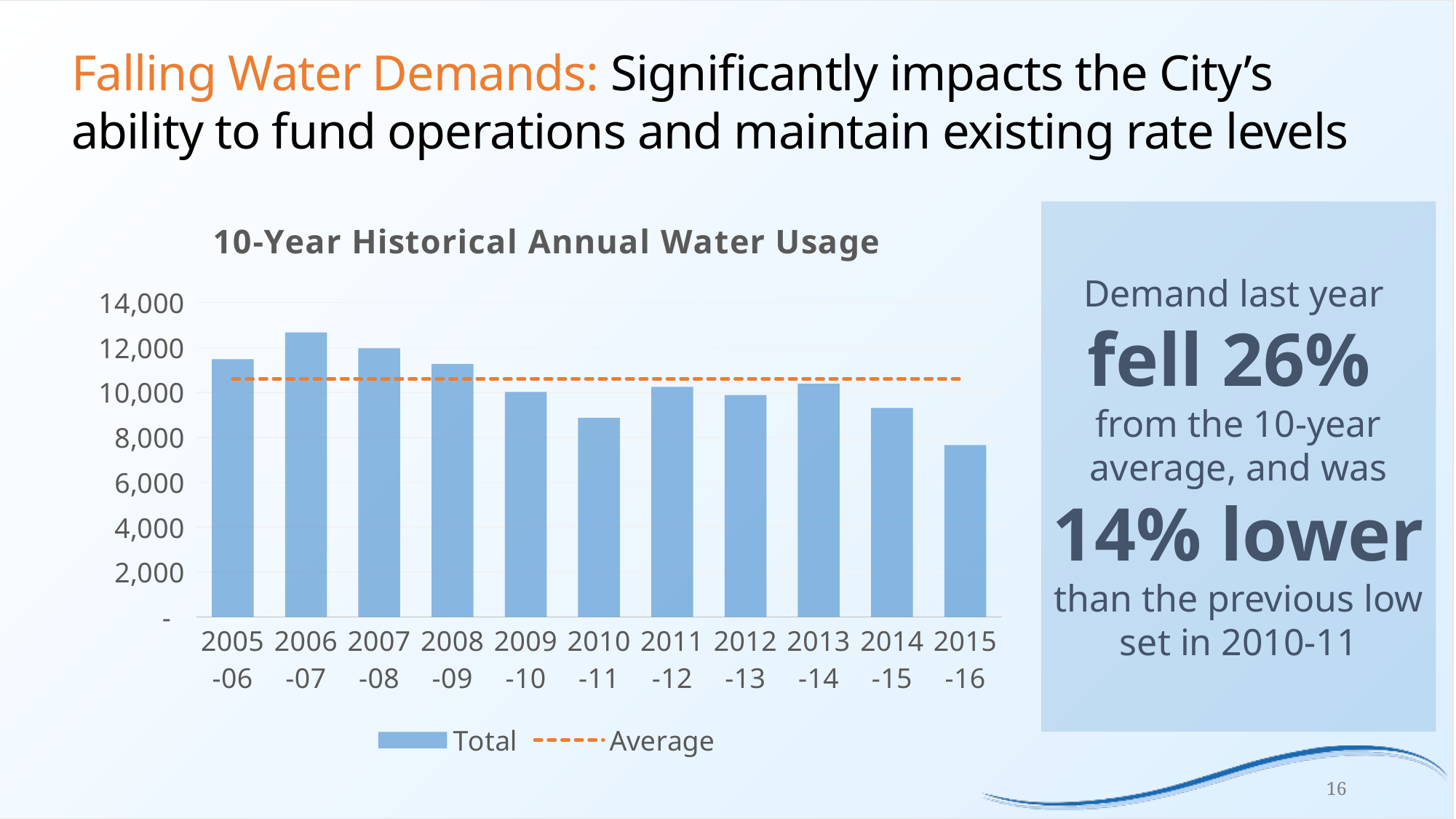
Is the value for 2006-07 greater or less than 12,000? greater Which is larger, the total for 2005-06 or the total for 2014-15? 2005-06 Which year has the lowest total water usage? 2015-16 Is the value for 2010-11 greater or less than 10,000? less What does the dashed orange line in the chart represent? Average What kind of chart is shown on the slide? bar chart How many entries does the chart legend list? 2 Is the value for 2015-16 greater or less than 8,000? less Which year has the highest total water usage? 2006-07 What is the title of the chart? 10-Year Historical Annual Water Usage How many years (bars) are plotted in the chart? 11 Overall, do the total water usage values rise or fall from 2005-06 to 2015-16? fall